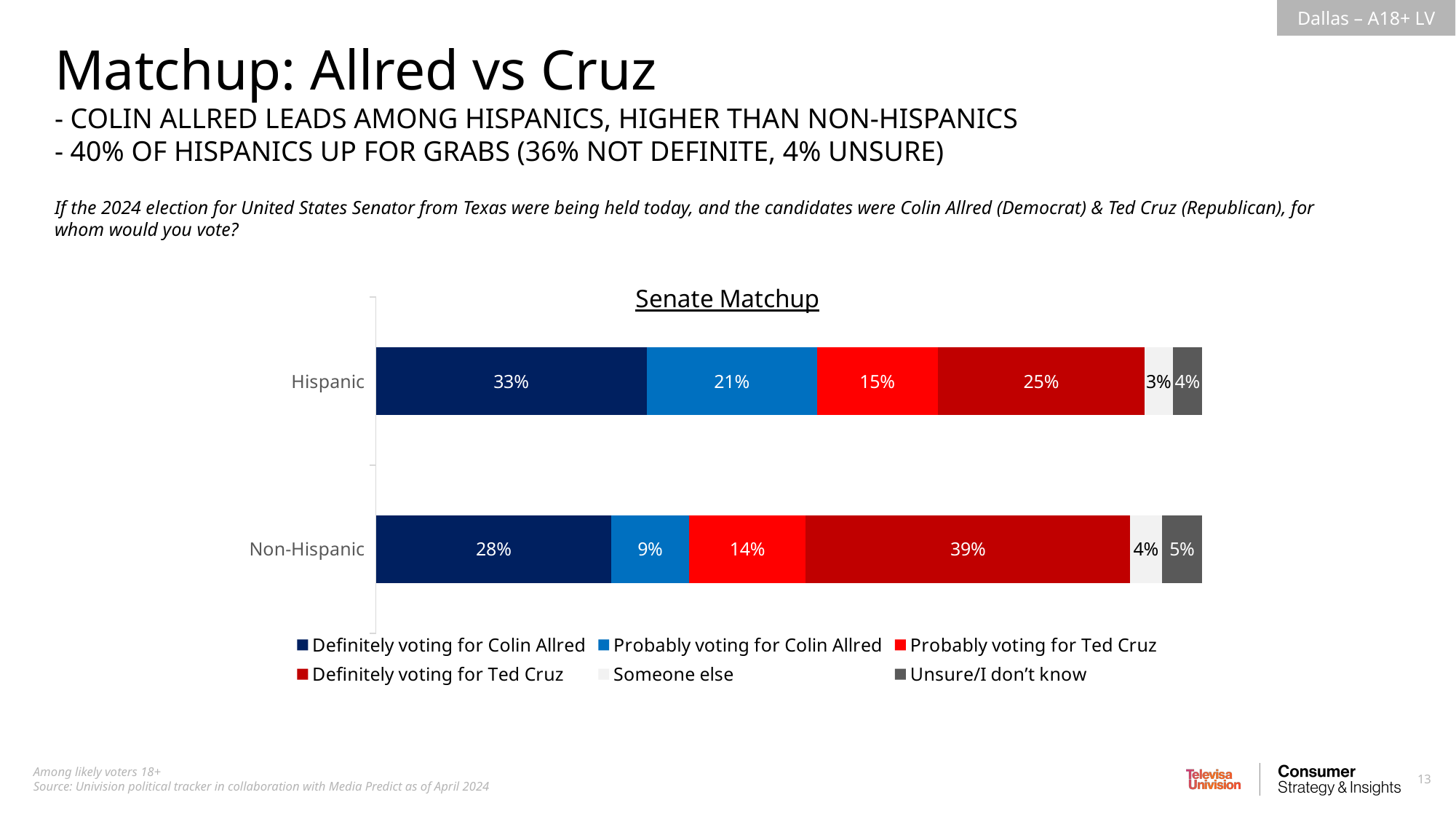
Which response category is the smallest for Hispanic respondents? Someone else How many groups (categories) are shown on the chart? 2 What is the difference between the Non-Hispanic and Hispanic shares definitely voting for Ted Cruz? 14% What percentage of Hispanic respondents are probably voting for Colin Allred? 21% What percentage of Hispanic respondents are definitely voting for Colin Allred? 33% What type of chart is shown? Stacked bar chart How many series does the legend list? 6 What percentage of Non-Hispanic respondents are definitely voting for Ted Cruz? 39% What percentage of Non-Hispanic respondents answered Unsure/I don't know? 5% Which group has the higher share definitely voting for Ted Cruz, Hispanic or Non-Hispanic? Non-Hispanic Which response category is the largest for Non-Hispanic respondents? Definitely voting for Ted Cruz What is the difference between the Hispanic and Non-Hispanic shares probably voting for Colin Allred? 12%